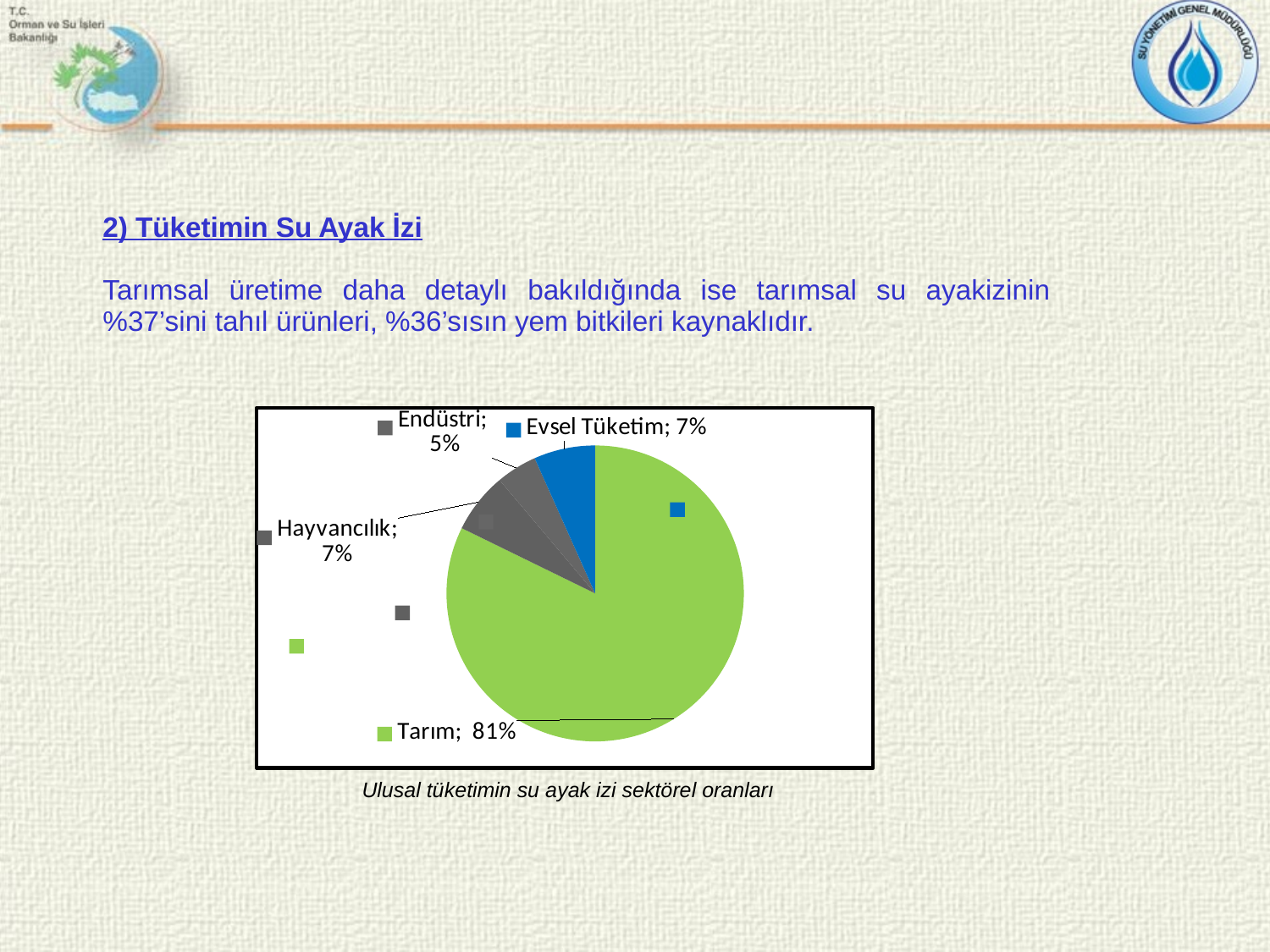
Which category has the smallest slice of the pie? Endüstri What is the caption written below the pie chart? Ulusal tüketimin su ayak izi sektörel oranları What share of the pie does Evsel Tüketim have? 7% Which is larger, the share for Evsel Tüketim or the share for Endüstri? Evsel Tüketim What kind of chart is shown on the slide? pie chart By how many percentage points does the Tarım share exceed the Endüstri share? 76 percentage points What share of the pie does Hayvancılık have? 7% What share of the pie does Endüstri have? 5% Which category has the largest slice of the pie? Tarım How many slices does the pie chart have? 4 What share of the pie does Tarım have? 81% Which is larger, the share for Tarım or the share for Hayvancılık? Tarım